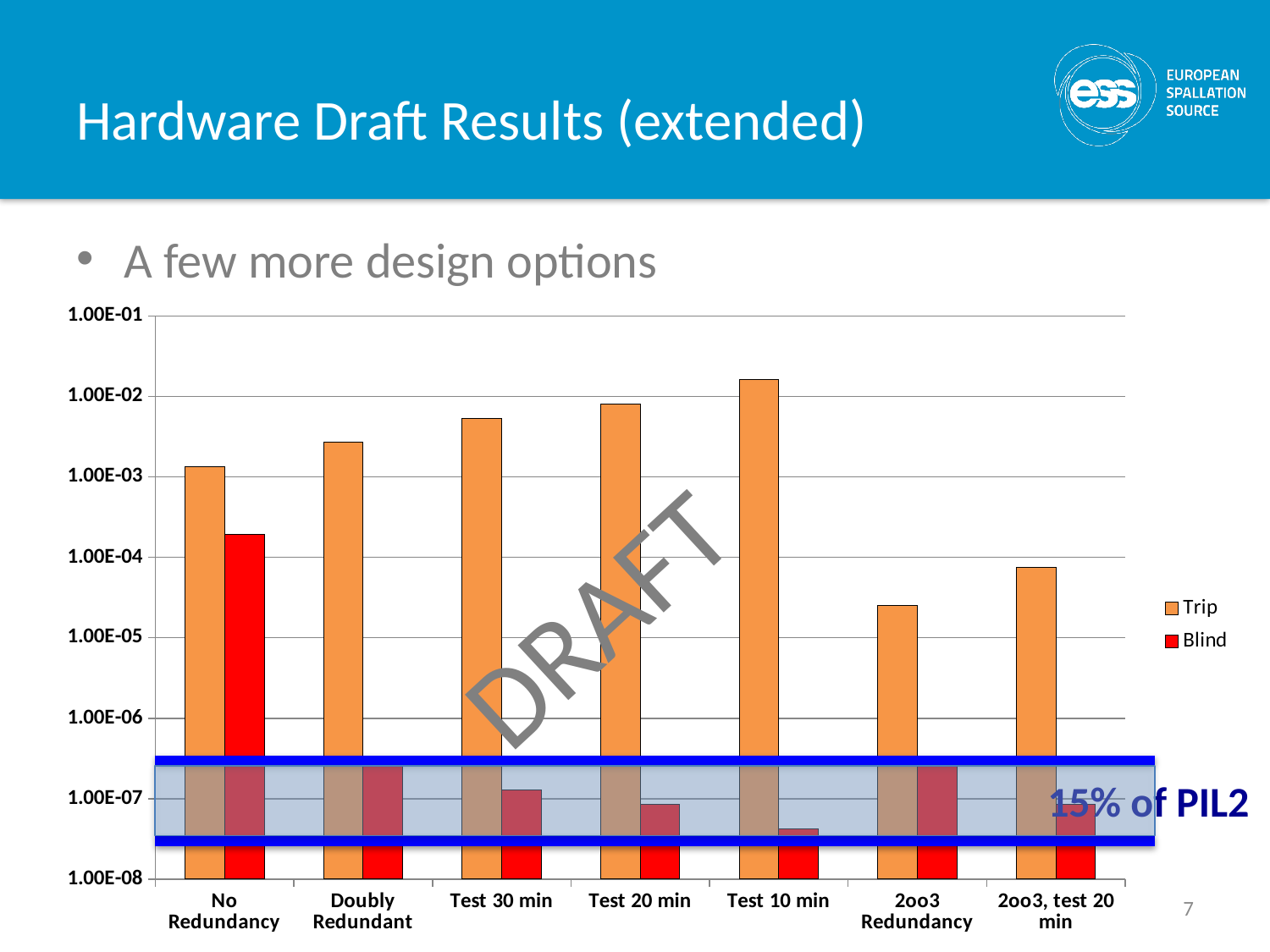
Which is larger, the Trip value for Test 10 min or the Trip value for No Redundancy? Test 10 min What are the two series named in the chart's legend? Trip and Blind Is the Trip value for Test 10 min greater or less than 1.00E-02? greater Which category has the highest Trip value? Test 10 min Which category has the highest Blind value? No Redundancy Is the Trip value for 2oo3 Redundancy greater or less than 1.00E-04? less Which category has the lowest Blind value? Test 10 min Is the Blind value for No Redundancy greater or less than 1.00E-04? greater How many design options (categories) are shown on the x axis of the chart? 7 What kind of chart is shown on the slide? Bar chart How many series does the chart's legend list? 2 Which category has the lowest Trip value? 2oo3 Redundancy